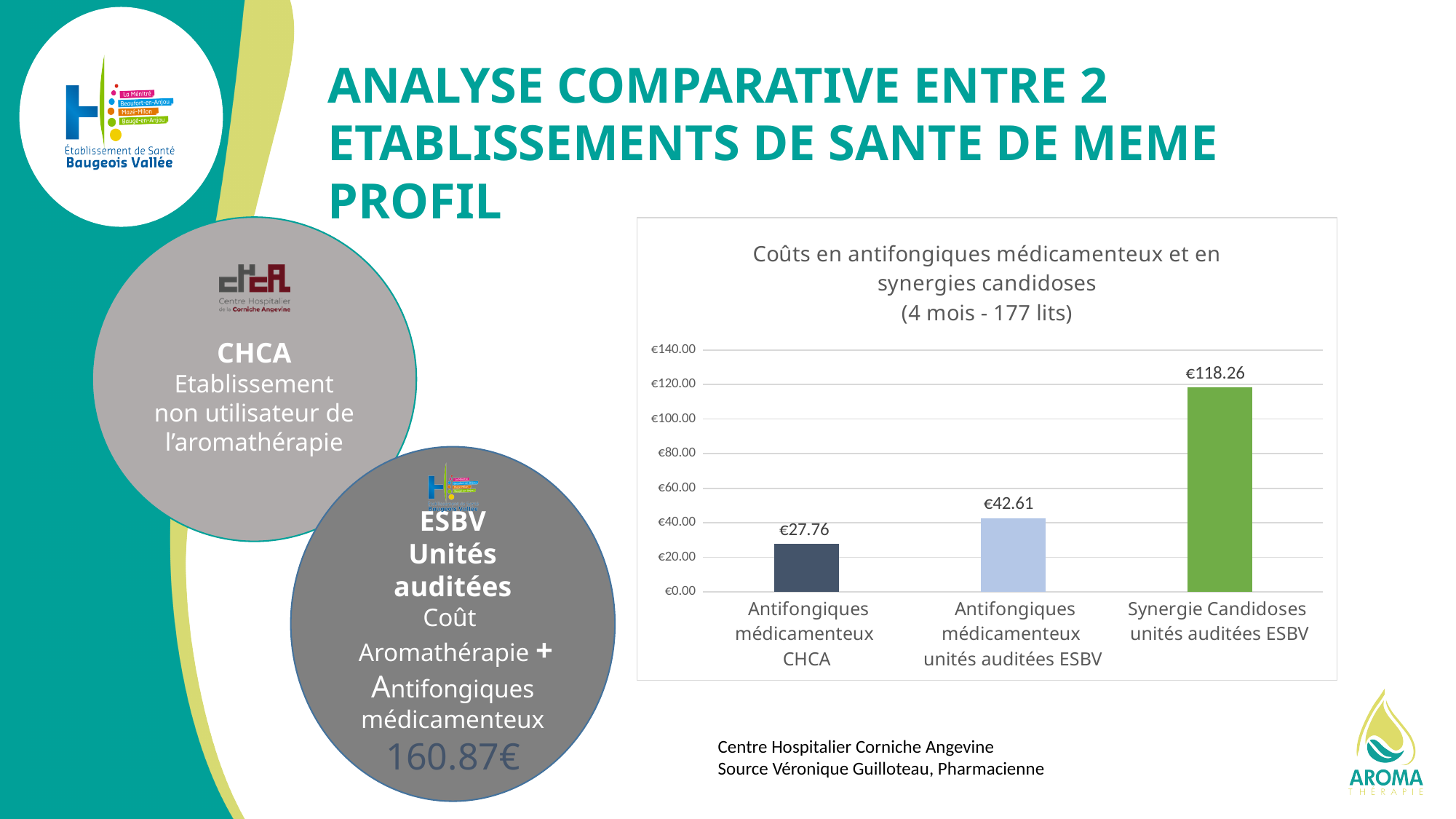
Is the value for Synergie Candidoses unités auditées ESBV greater or less than €100.00? greater What is the difference between Synergie Candidoses unités auditées ESBV and Antifongiques médicamenteux CHCA? €90.50 What is the value for Antifongiques médicamenteux CHCA? €27.76 Which is larger: Antifongiques médicamenteux CHCA or Antifongiques médicamenteux unités auditées ESBV? Antifongiques médicamenteux unités auditées ESBV What is the value for Synergie Candidoses unités auditées ESBV? €118.26 How many categories are shown in the chart? 3 What is the difference between Antifongiques médicamenteux unités auditées ESBV and Antifongiques médicamenteux CHCA? €14.85 What kind of chart is shown on the slide? bar chart Which category has the lowest value? Antifongiques médicamenteux CHCA Which category has the highest value? Synergie Candidoses unités auditées ESBV What is the title of the chart? Coûts en antifongiques médicamenteux et en synergies candidoses (4 mois - 177 lits) What is the value for Antifongiques médicamenteux unités auditées ESBV? €42.61